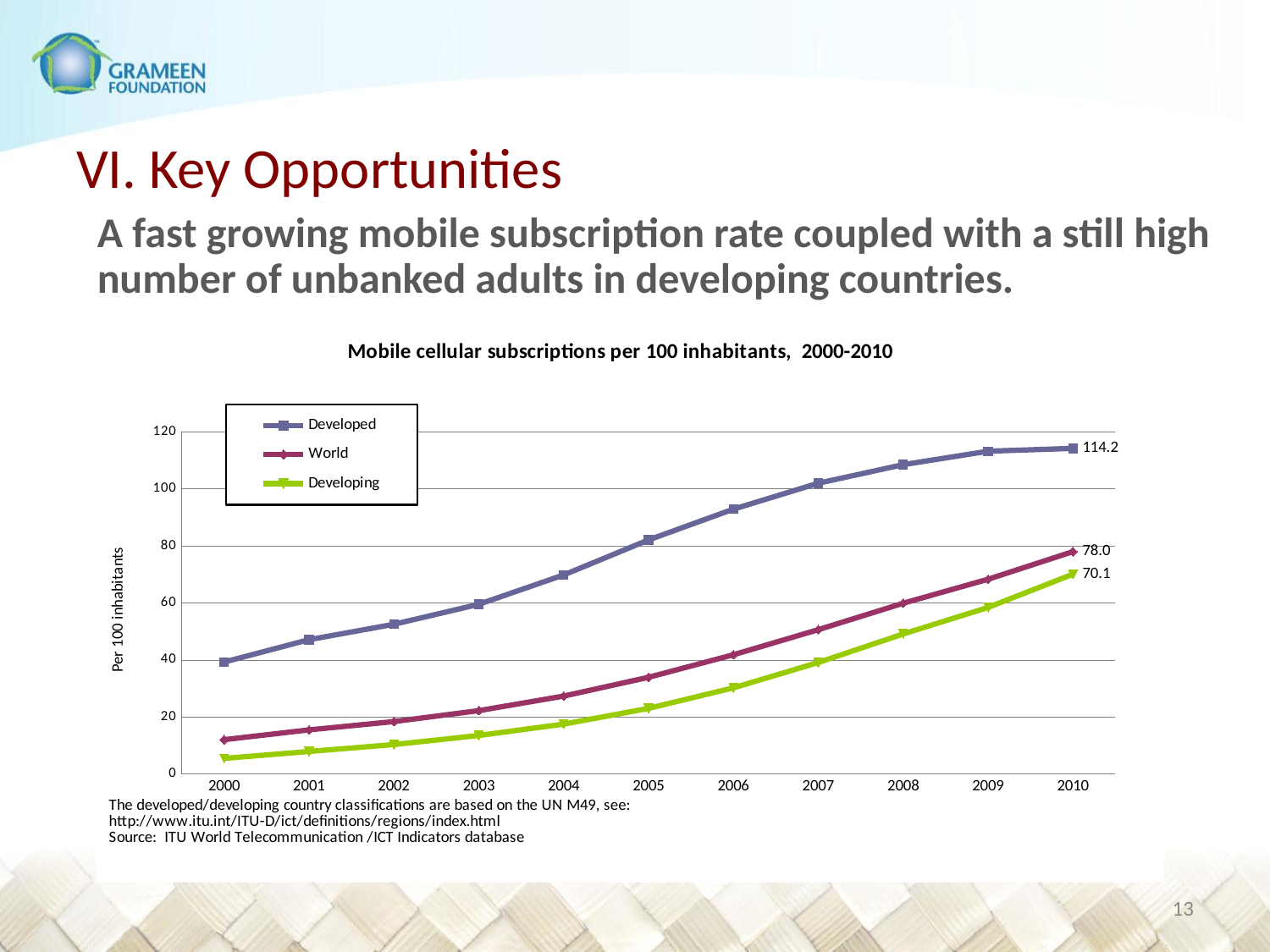
What is the value for Developed in 2010? 114.2 What is the difference between the Developed and World values in 2010? 36.2 Which series has the lowest value in 2010? Developing What is the value for World in 2010? 78.0 Is the value for Developed in 2000 greater or less than 60? less How many years are shown on the x axis? 11 Is the value for Developing in 2005 greater or less than 40? less What is the value for Developing in 2010? 70.1 Which series has the highest value in 2010? Developed What kind of chart is shown? line chart Which is larger in 2010, the World value or the Developing value? World How many series does the legend list? 3